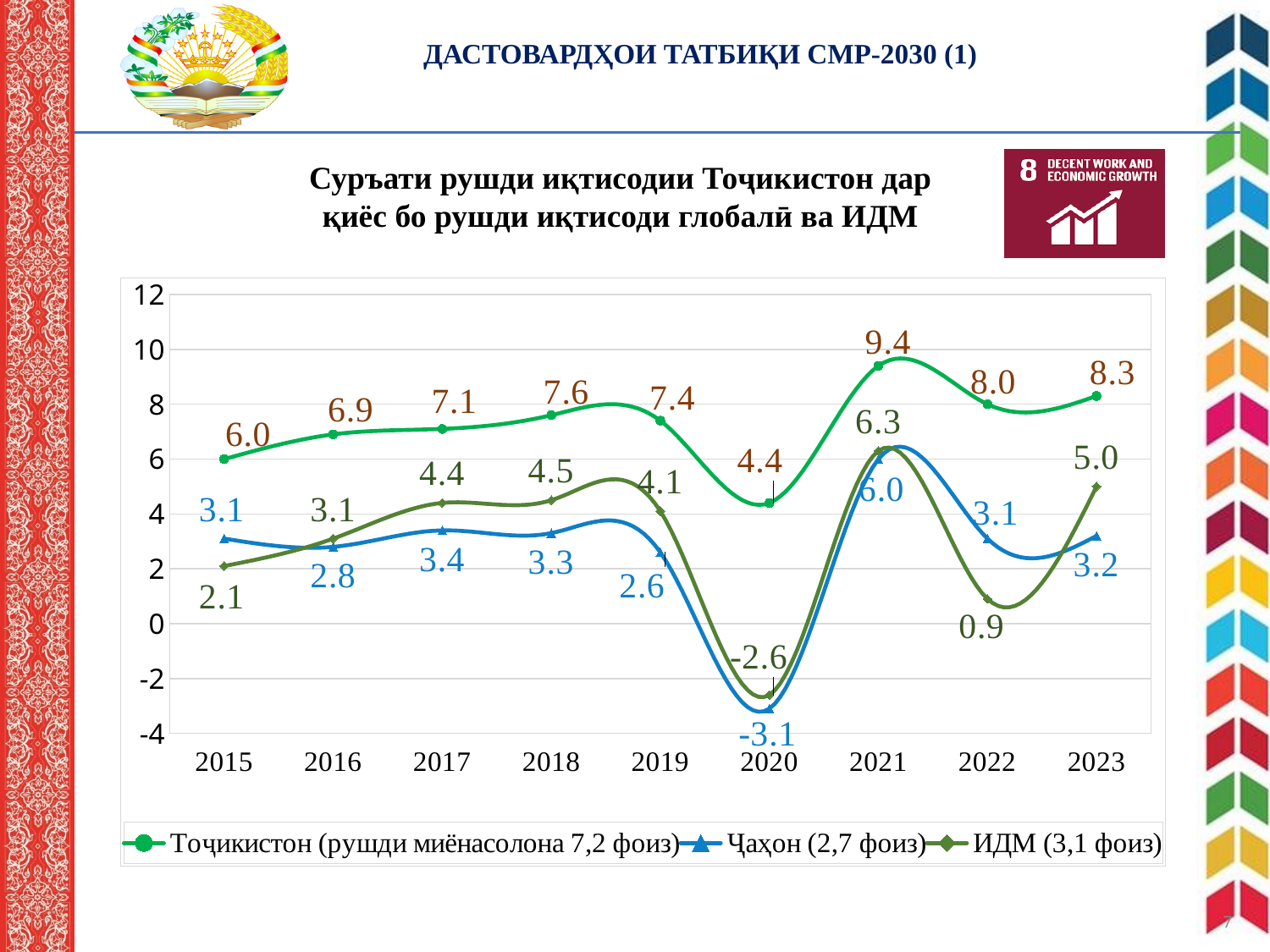
What is the value for Тоҷикистон in 2021? 9.4 How many years are shown on the x axis? 9 In which year does the Тоҷикистон series reach its highest value? 2021 What is the difference between the Тоҷикистон value and the Ҷаҳон value in 2023? 5.1 What kind of chart is shown on the slide? Line chart In which year does the ИДМ series reach its lowest value? 2020 What is the value for ИДМ in 2022? 0.9 Which is larger in 2021: the Ҷаҳон value or the ИДМ value? ИДМ What is the value for Ҷаҳон in 2020? -3.1 Does the Тоҷикистон series rise or fall from 2015 to 2018? Rise How many series does the legend list? 3 What colour is the line for the Ҷаҳон series? Blue